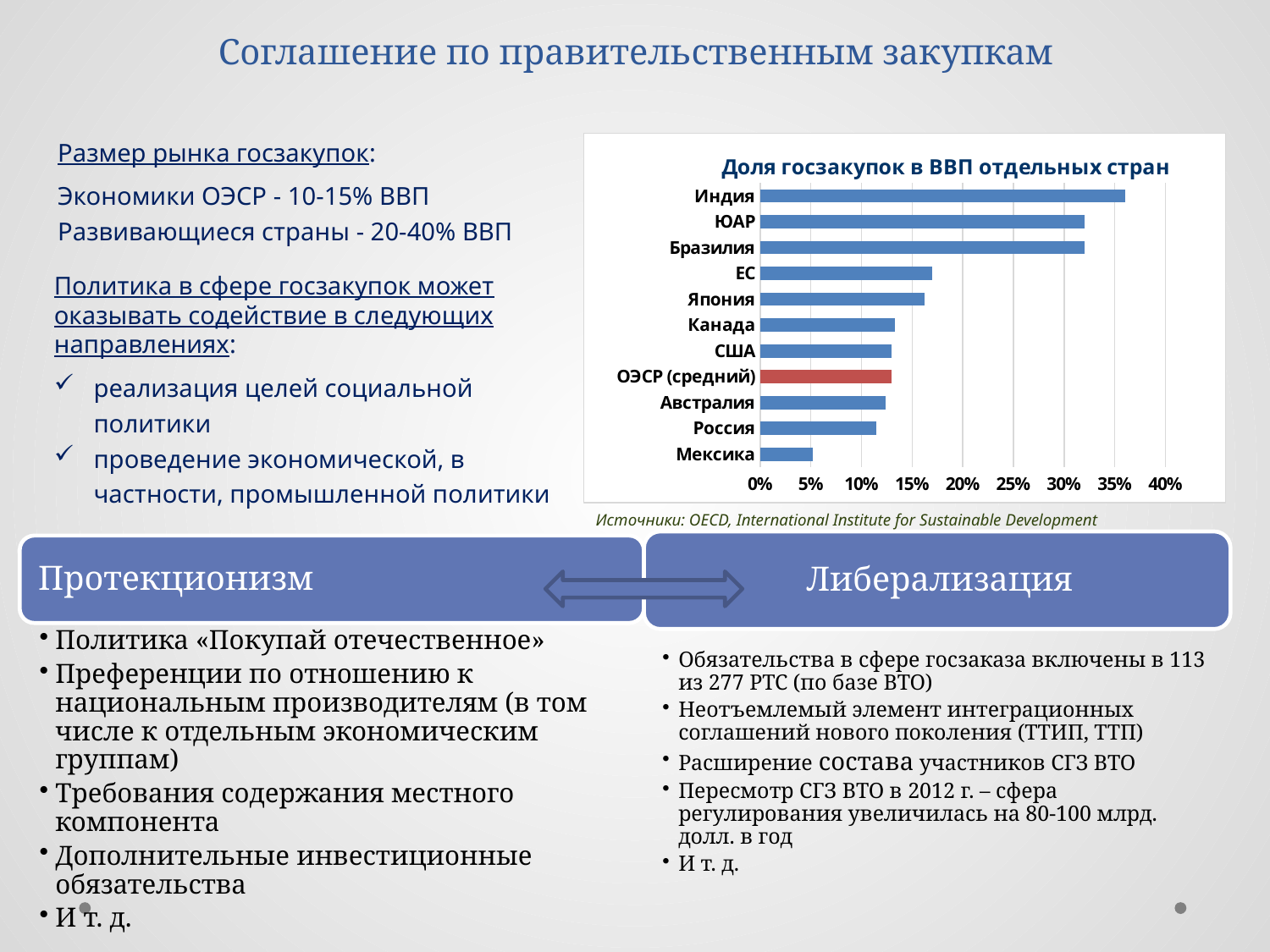
Is the value for Индия greater or less than 30%? greater Which country has the highest share of government procurement in GDP in the chart? Индия What is the title of the chart? Доля госзакупок в ВВП отдельных стран Which country has the lowest share of government procurement in GDP in the chart? Мексика What kind of chart is shown on the slide? bar chart Is the value for Россия greater or less than 10%? greater How many countries or groups are shown in the chart? 11 Is the value for Мексика greater or less than 10%? less Which has a larger value, Бразилия or Япония? Бразилия Which bar in the chart is coloured red instead of blue? ОЭСР (средний) Which has a larger value, ЕС or Канада? ЕС